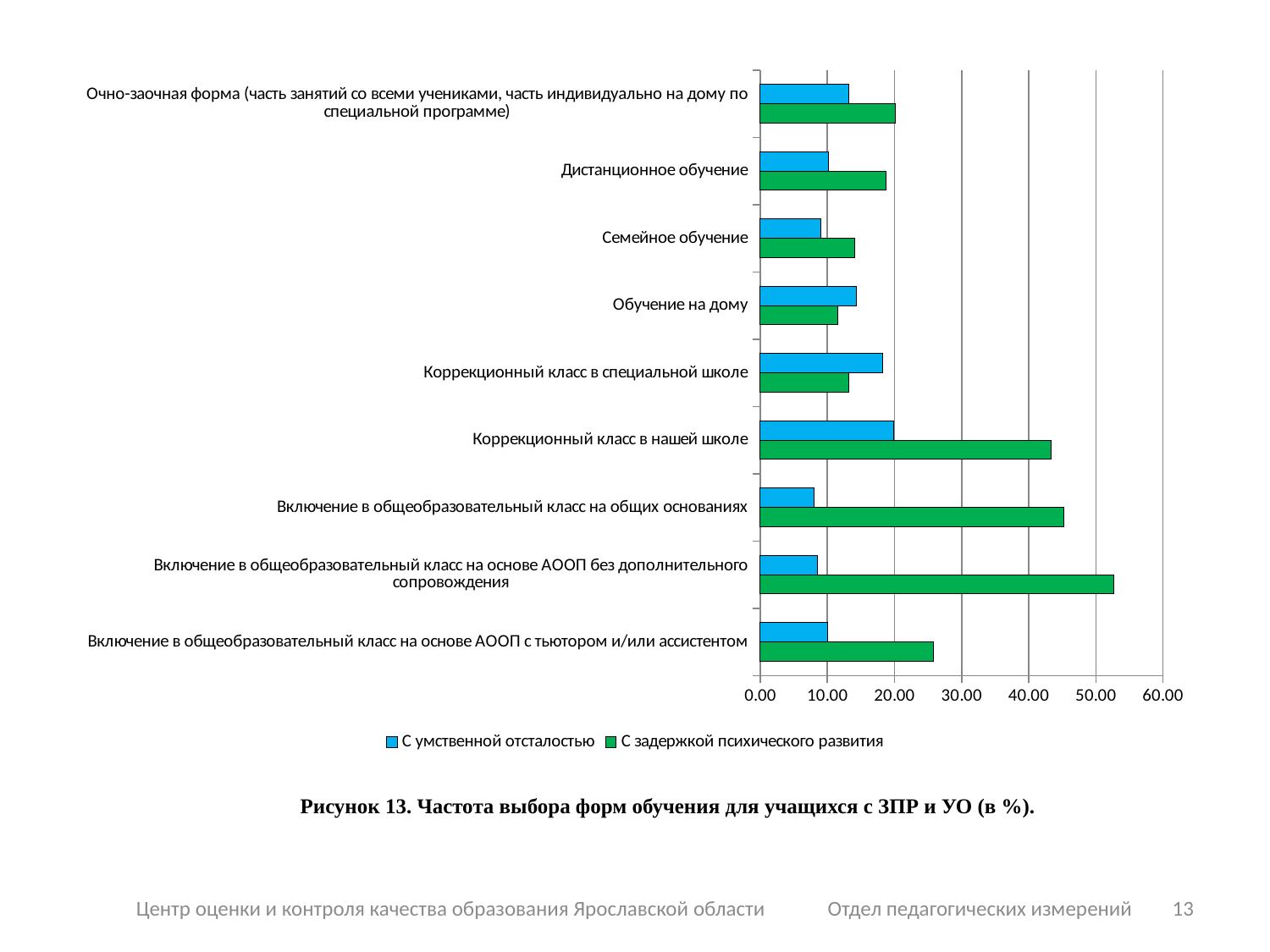
What kind of chart is shown on the slide? bar chart For the category "Коррекционный класс в нашей школе", which series has the larger value? С задержкой психического развития Is the value for "С задержкой психического развития" in the category "Включение в общеобразовательный класс на общих основаниях" greater or less than 40.00? greater What is the caption (figure title) given below the chart? Рисунок 13. Частота выбора форм обучения для учащихся с ЗПР и УО (в %). For the category "Коррекционный класс в специальной школе", which series has the larger value? С умственной отсталостью How many categories (forms of education) are shown on the chart? 9 Is the value for "С умственной отсталостью" in the category "Включение в общеобразовательный класс на общих основаниях" greater or less than 10.00? less Is the value for "С задержкой психического развития" in the category "Включение в общеобразовательный класс на основе АООП с тьютором и/или ассистентом" greater or less than 20.00? greater How many series does the legend list? 2 Which category has the highest value for the series "С задержкой психического развития"? Включение в общеобразовательный класс на основе АООП без дополнительного сопровождения Which series is shown in green in the legend? С задержкой психического развития